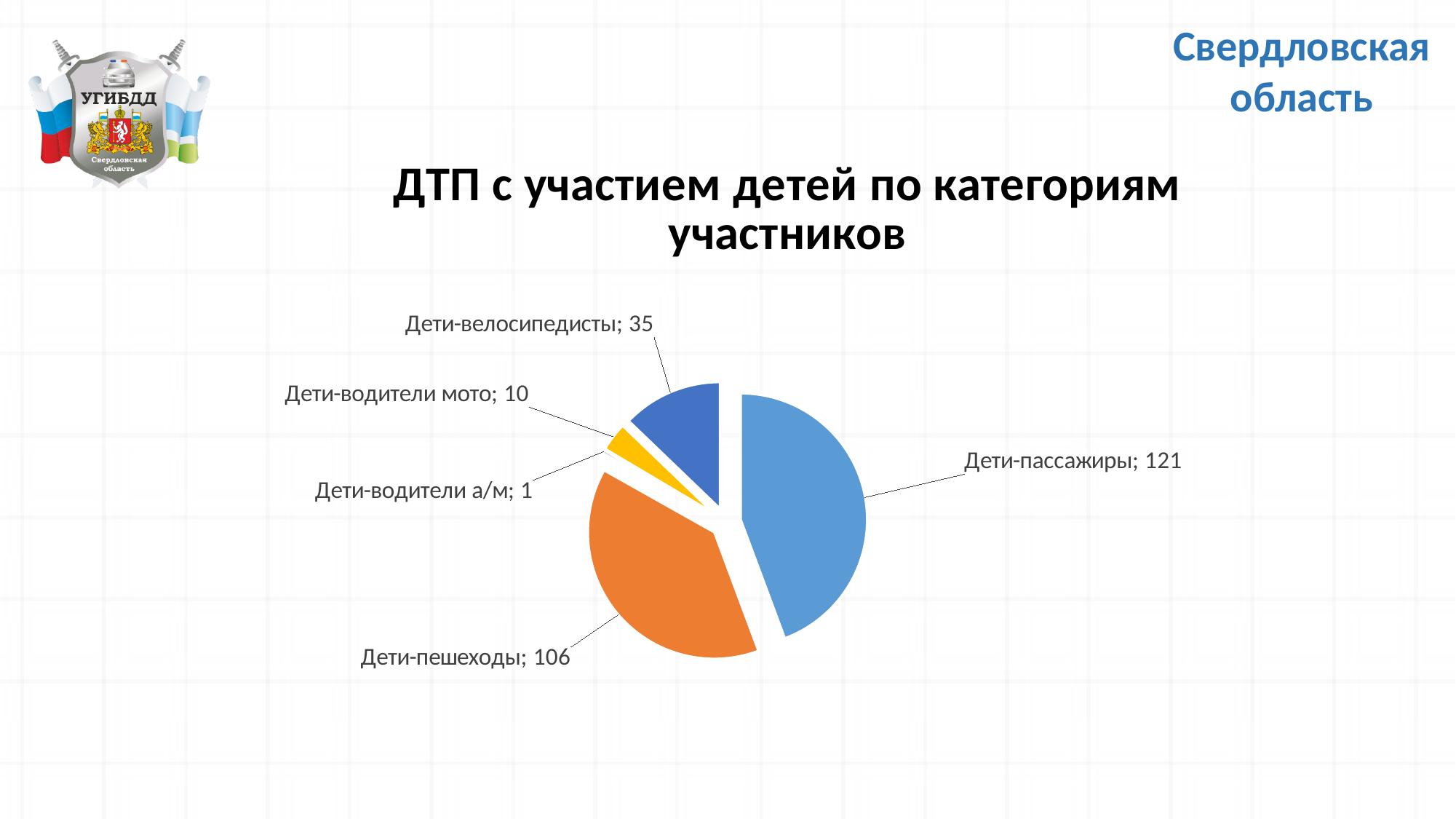
Which category has the largest value? Дети-пассажиры What is the value for Дети-пешеходы? 106 What is the value for Дети-водители мото? 10 How many categories does the pie chart show? 5 Which category has the smallest value? Дети-водители а/м What is the difference between the values for Дети-пассажиры and Дети-пешеходы? 15 What kind of chart is shown on the slide? Pie chart What is the title of the chart? ДТП с участием детей по категориям участников What is the total of all categories in the pie chart? 273 Which is larger, the value for Дети-велосипедисты or the value for Дети-водители мото? Дети-велосипедисты What is the value for Дети-пассажиры? 121 What is the value for Дети-велосипедисты? 35